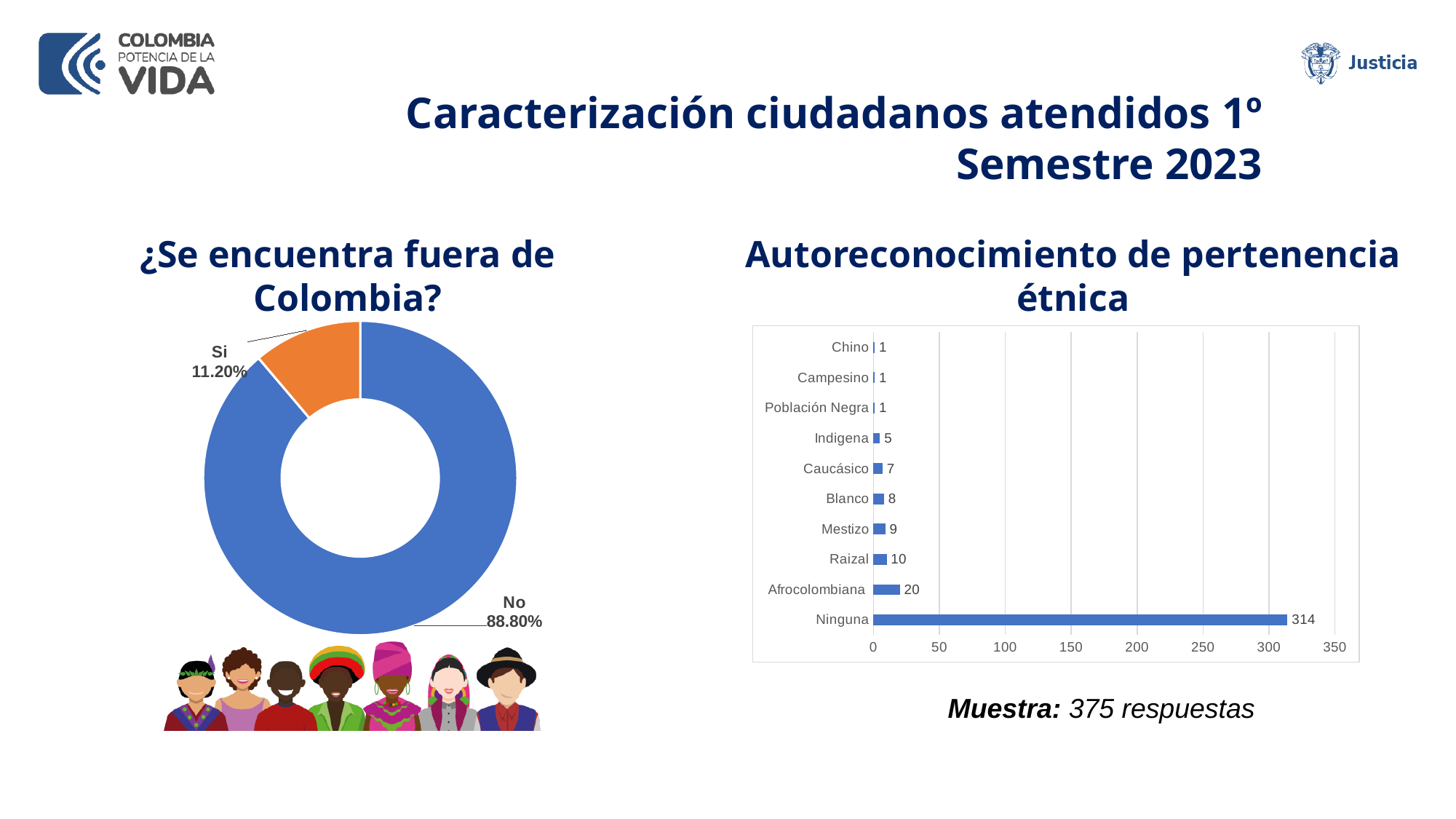
In the '¿Se encuentra fuera de Colombia?' chart, what percentage answered 'Si'? 11.20% What kind of chart is 'Autoreconocimiento de pertenencia étnica'? Bar chart In the 'Autoreconocimiento de pertenencia étnica' chart, which is larger, Raizal or Mestizo? Raizal In the 'Autoreconocimiento de pertenencia étnica' chart, how many categories are shown? 10 In the 'Autoreconocimiento de pertenencia étnica' chart, what is the value for Afrocolombiana? 20 What kind of chart is '¿Se encuentra fuera de Colombia?'? Doughnut (pie) chart In the 'Autoreconocimiento de pertenencia étnica' chart, is the value for Ninguna greater or less than 300? greater In the '¿Se encuentra fuera de Colombia?' chart, what percentage answered 'No'? 88.80% In the 'Autoreconocimiento de pertenencia étnica' chart, what is the difference between Ninguna and Afrocolombiana? 294 In the 'Autoreconocimiento de pertenencia étnica' chart, what is the value for Ninguna? 314 In the '¿Se encuentra fuera de Colombia?' chart, which slice is larger, 'Si' or 'No'? No In the 'Autoreconocimiento de pertenencia étnica' chart, which category has the highest value? Ninguna